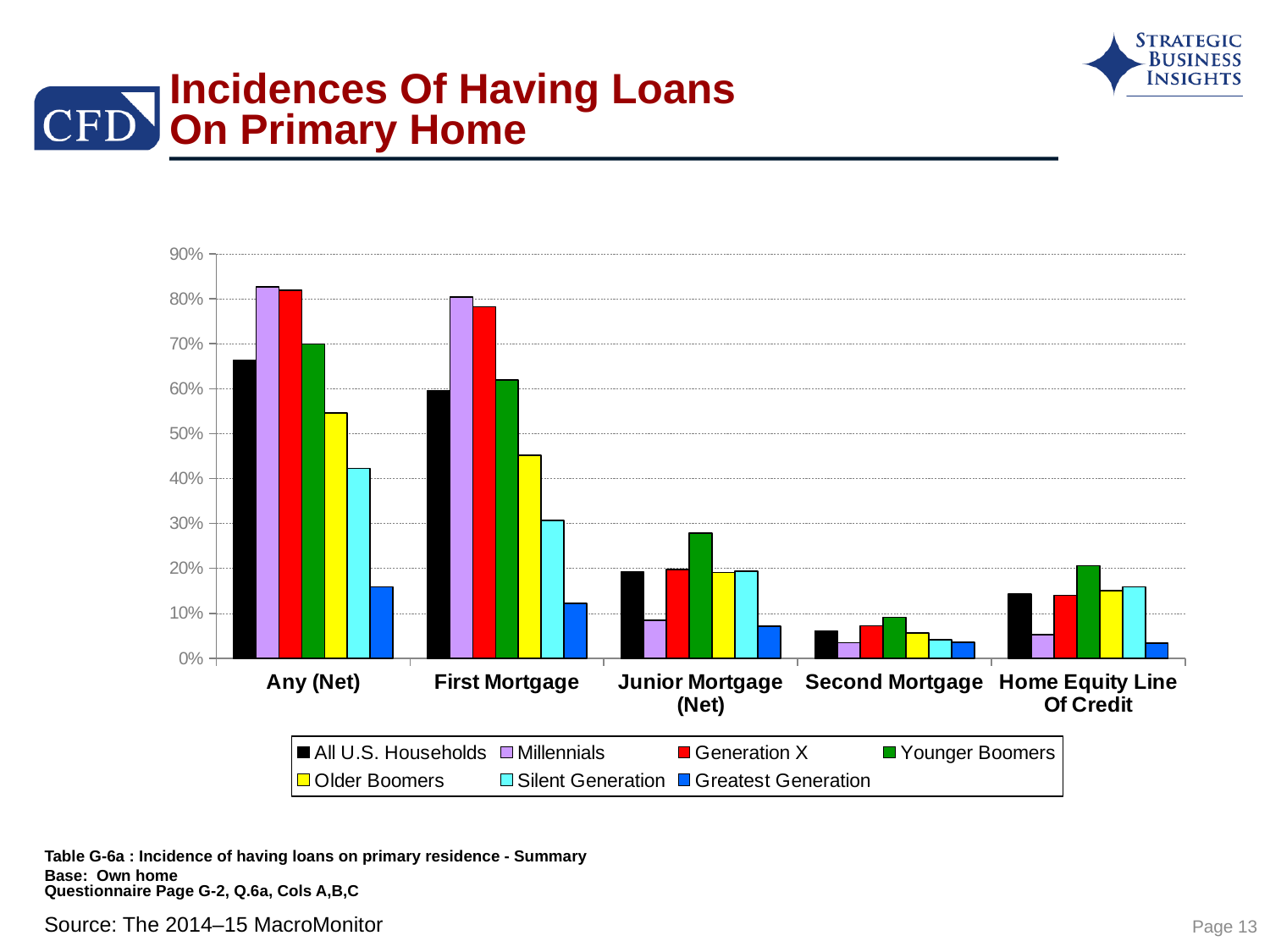
Is the value for Silent Generation in the First Mortgage category greater or less than 40%? less What colour represents Generation X in the legend? Red In the First Mortgage category, which is larger: Older Boomers or Silent Generation? Older Boomers Which series has the highest value in the Junior Mortgage (Net) category? Younger Boomers What kind of chart is shown on the slide? Bar chart Is the value for All U.S. Households in the Any (Net) category greater or less than 60%? greater Which series has the lowest value in the First Mortgage category? Greatest Generation How many series does the legend list? 7 How many loan categories are shown along the x axis? 5 Do the All U.S. Households values rise or fall from Any (Net) to Second Mortgage? fall Is the value for Greatest Generation in the Any (Net) category greater or less than 20%? less For All U.S. Households, which category has the lowest value? Second Mortgage